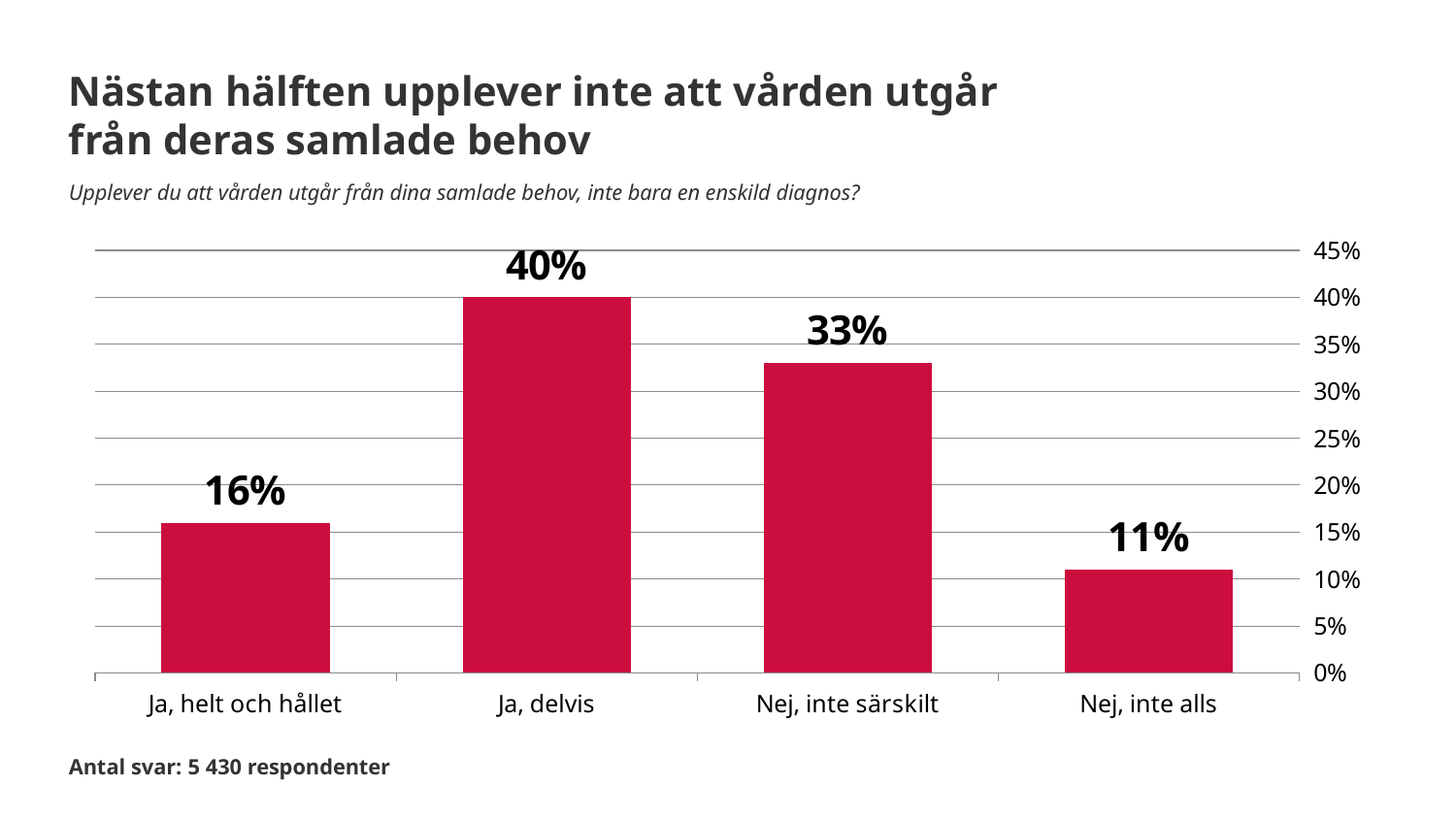
What kind of chart is shown on the slide? bar chart What is the total of the values for "Nej, inte särskilt" and "Nej, inte alls"? 44% How many categories are shown on the x axis? 4 Which is larger, the value for "Ja, helt och hållet" or the value for "Nej, inte alls"? Ja, helt och hållet Which category has the highest value? Ja, delvis What is the value for "Ja, helt och hållet"? 16% Is the value for "Nej, inte särskilt" greater or less than 30%? greater What is the value for "Nej, inte alls"? 11% What is the value for "Ja, delvis"? 40% Which category has the lowest value? Nej, inte alls How many respondents answered the survey, according to the note below the chart? 5 430 What is the difference between the values for "Ja, delvis" and "Nej, inte särskilt"? 7%